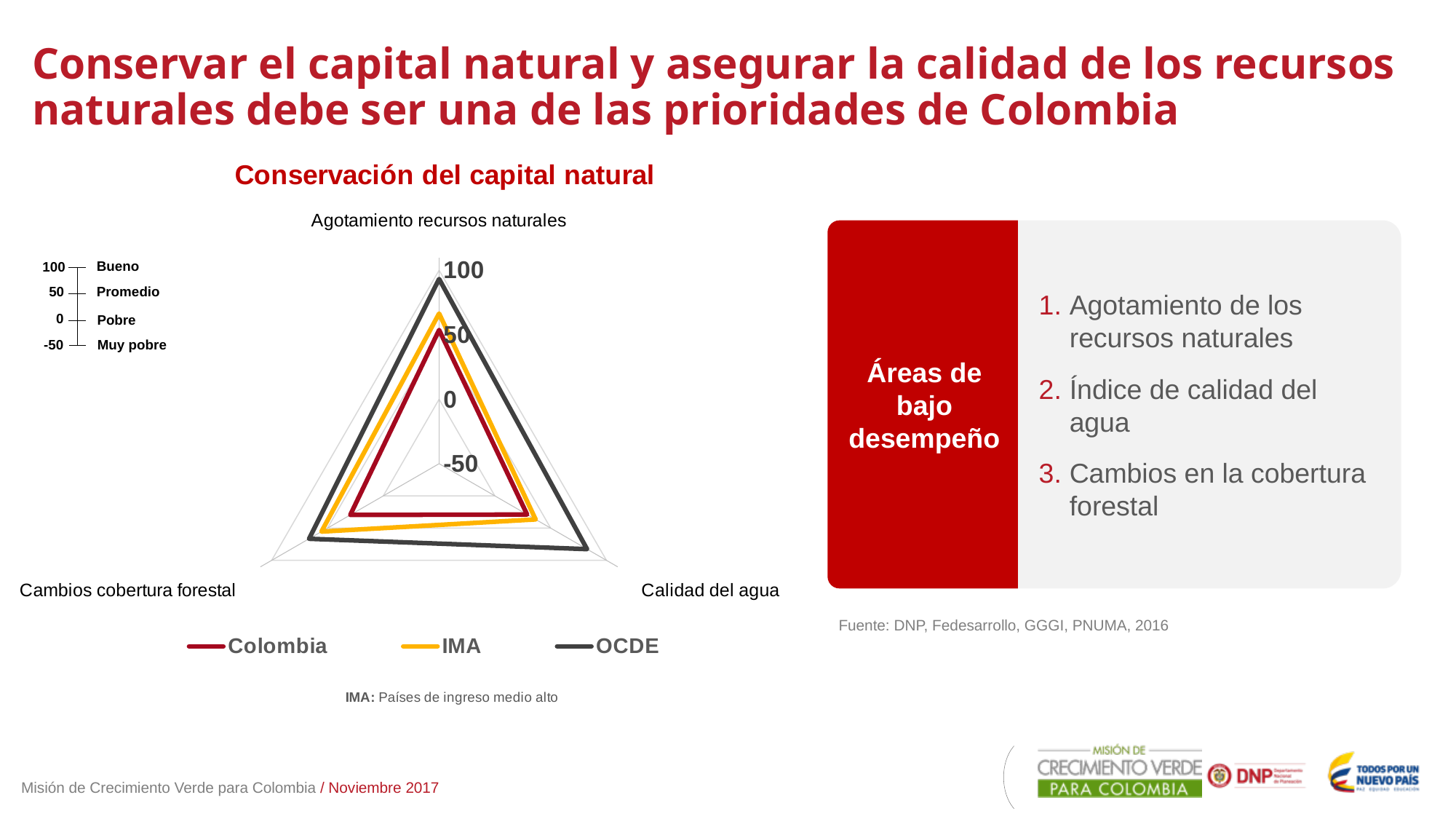
Which colour is used for the Colombia series in the chart? Red Is the value for OCDE on the Agotamiento recursos naturales axis greater or less than 50? greater Which series has the highest value on the Agotamiento recursos naturales axis? OCDE Which series has the lowest value on the Calidad del agua axis? Colombia Which series has the lowest value on the Agotamiento recursos naturales axis? Colombia What kind of chart is shown on the slide? Radar chart How many series does the chart legend list? 3 How many indicator axes does the radar chart have? 3 Is the value for Colombia on the Cambios cobertura forestal axis greater or less than 50? less What is the title of the chart? Conservación del capital natural Is the value for Colombia on the Calidad del agua axis greater or less than 50? less On the Calidad del agua axis, which is larger: the value for OCDE or the value for Colombia? OCDE